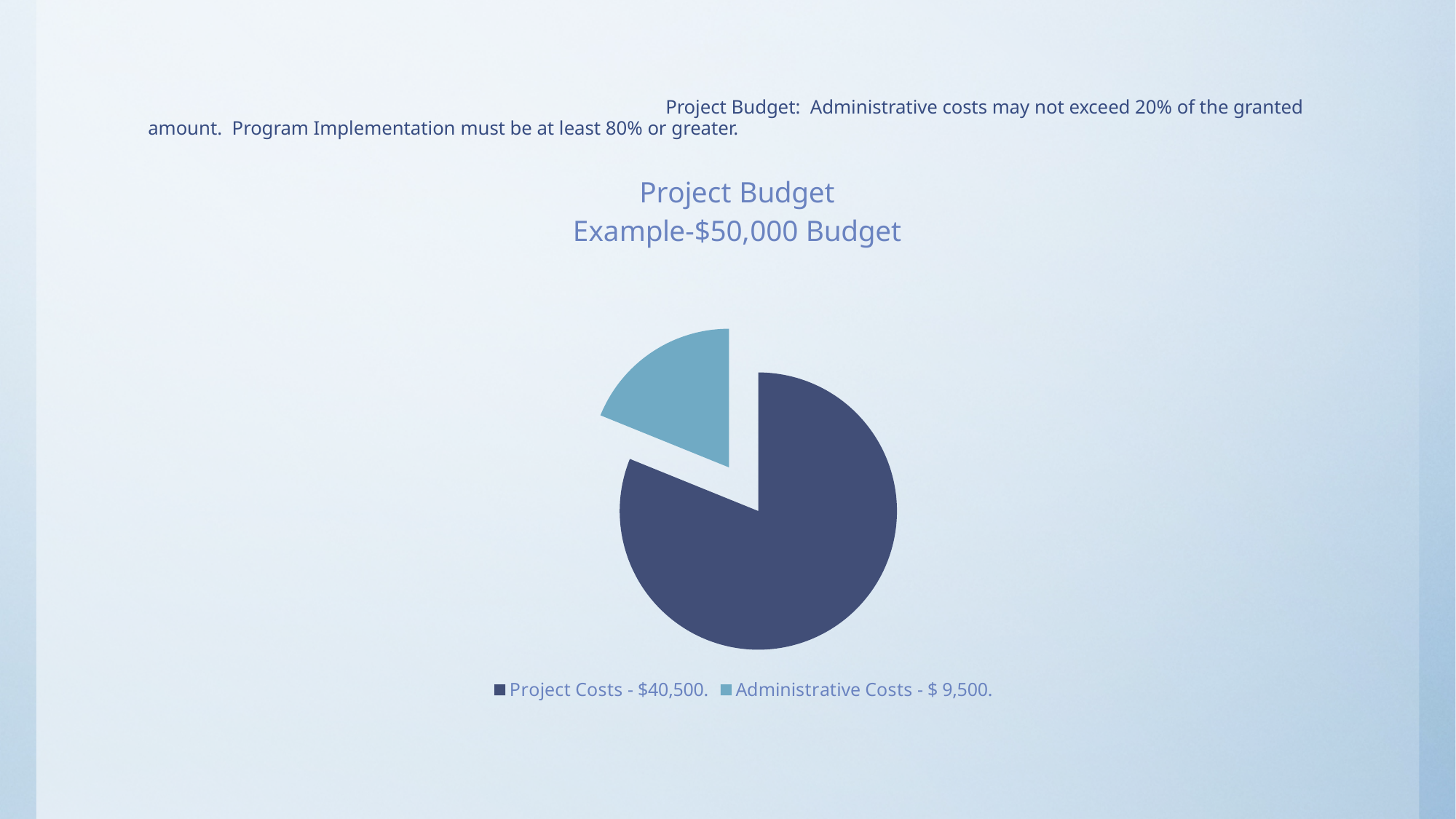
How many entries does the legend list? 2 What is the difference between Project Costs and Administrative Costs? $31,000 Which is larger, Project Costs or Administrative Costs? Project Costs Which category has the largest slice of the pie? Project Costs How many slices does the pie chart have? 2 What kind of chart is shown on the slide? Pie chart Which colour represents Administrative Costs in the pie chart? Light blue Which category has the smallest slice of the pie? Administrative Costs What is the value for Project Costs according to the legend? $40,500 What is the value for Administrative Costs according to the legend? $ 9,500 What is the title of the chart? Project Budget Example-$50,000 Budget What share of the $50,000 budget do Administrative Costs represent? 19%